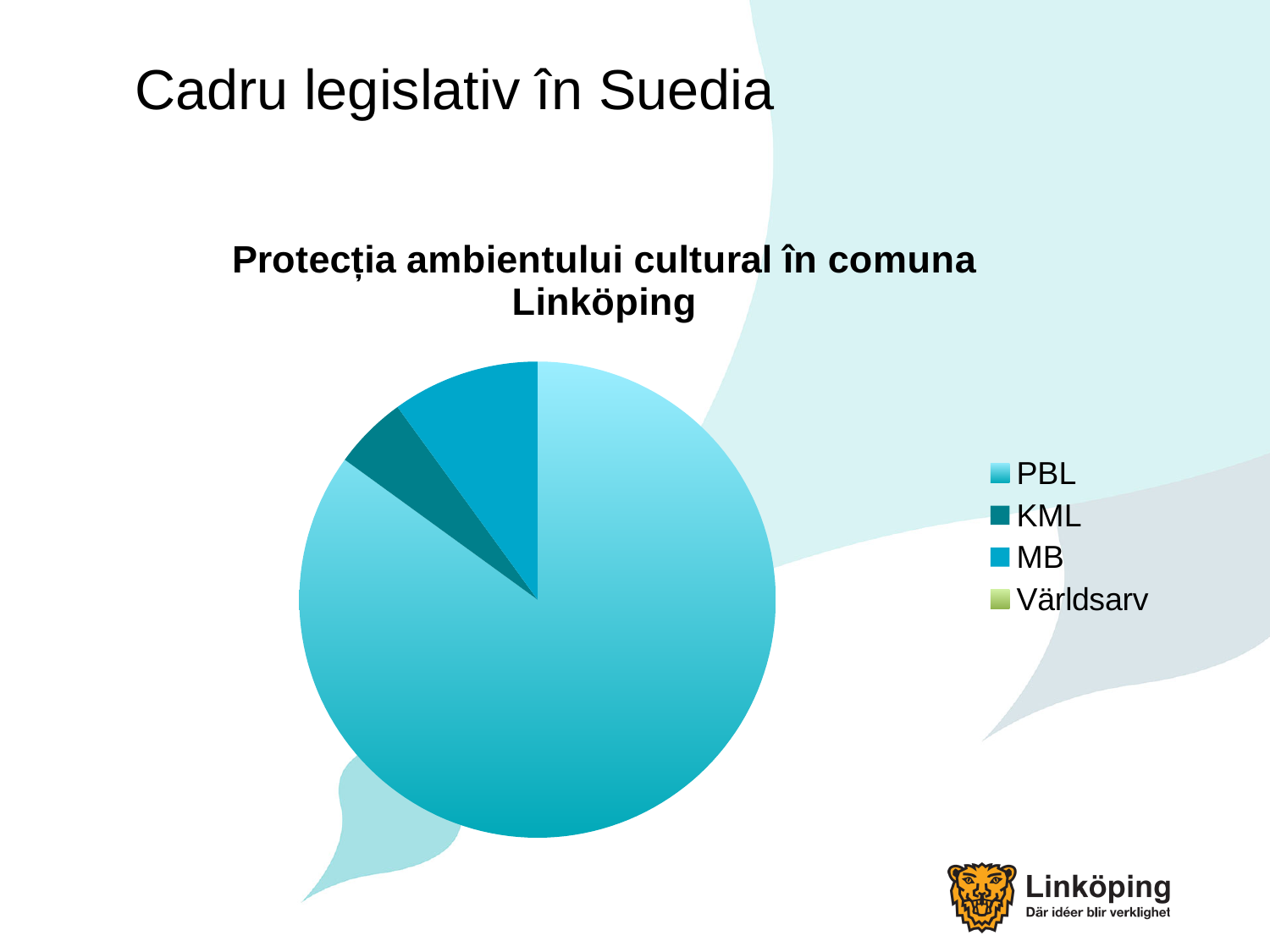
What is the title of the chart? Protecția ambientului cultural în comuna Linköping Which slice is larger, PBL or KML? PBL What kind of chart is shown on the slide? Pie chart Which slice is larger, MB or KML? MB How many entries does the chart's legend list? 4 Which legend entry is listed last in the chart's legend? Världsarv Which category has the largest slice of the pie? PBL Which slice is larger, PBL or MB? PBL